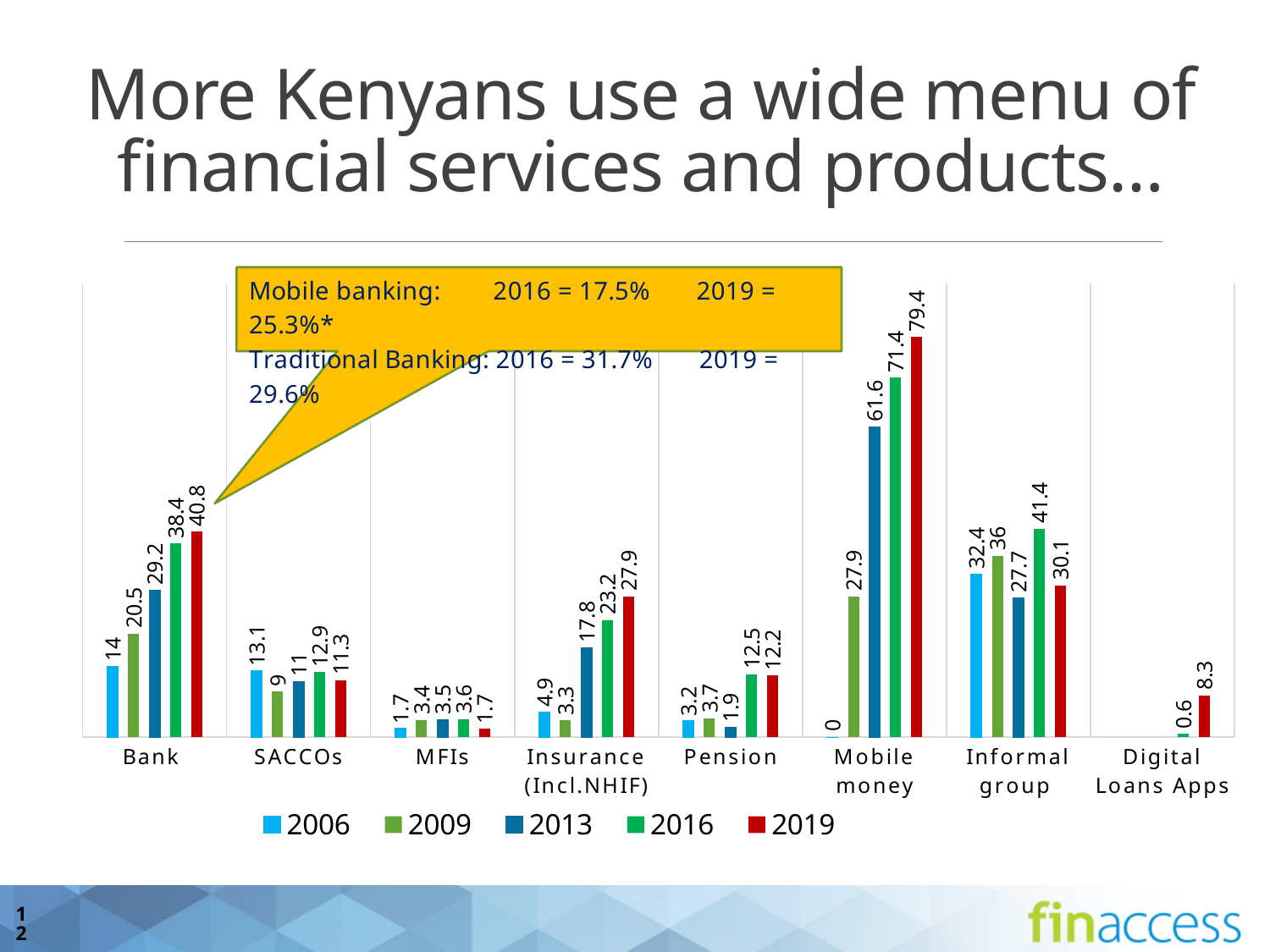
Which category has the highest value in 2019? Mobile money What is the value for Digital Loans Apps in 2019? 8.3 What colour represents the 2019 series in the legend? red What is the value for Bank in 2019? 40.8 What is the difference between the Bank values for 2019 and 2006? 26.8 How many categories are shown on the x axis? 8 Do the Mobile money values rise or fall from 2006 to 2019? rise What is the value for Mobile money in 2013? 61.6 What kind of chart is shown on the slide? bar chart Which category has the lowest value in 2019? MFIs Which is larger in 2016: Informal group or Insurance (Incl.NHIF)? Informal group How many series does the legend list? 5